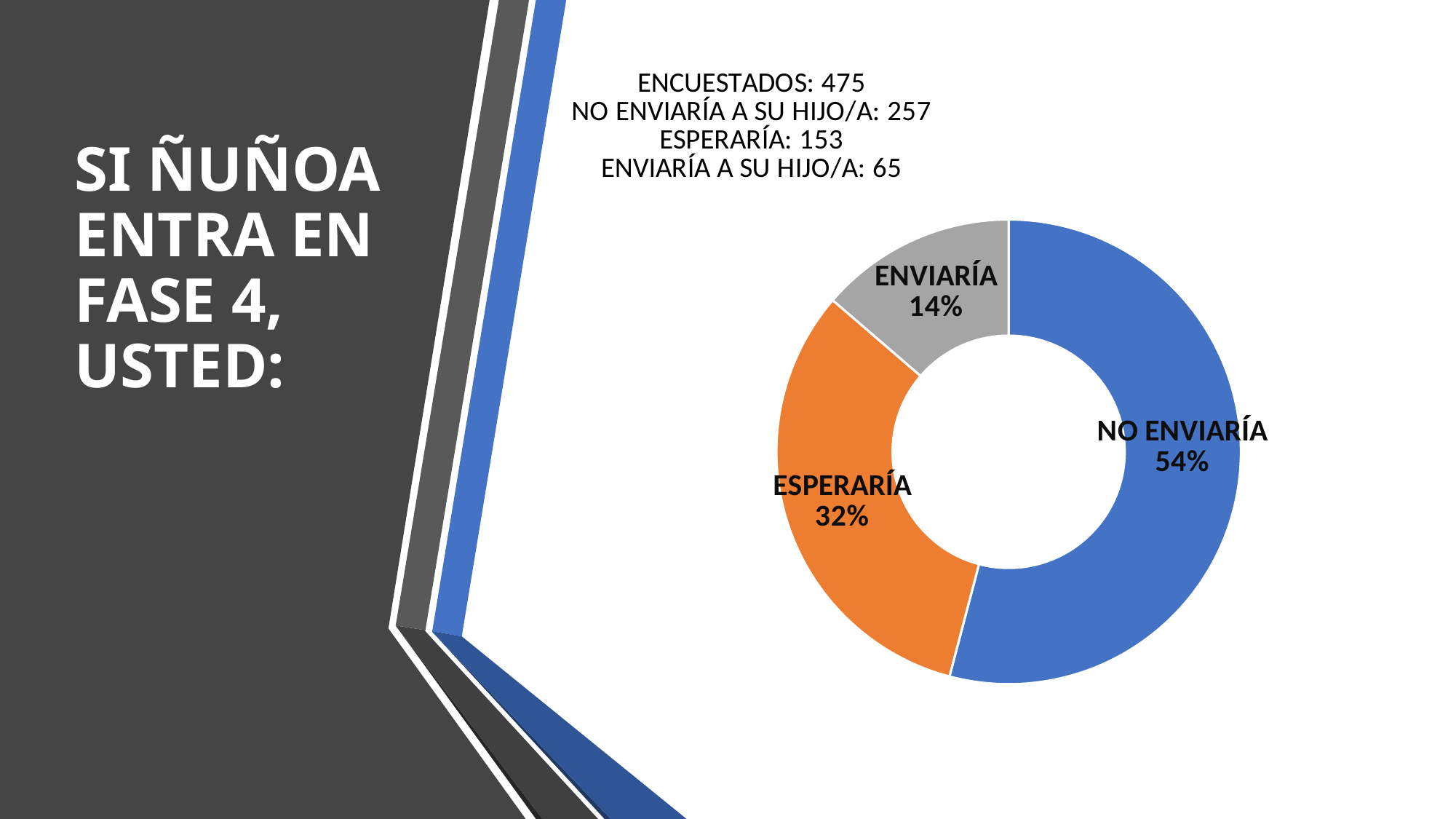
What is the difference in percentage points between the NO ENVIARÍA and ESPERARÍA slices? 22 What percentage of the doughnut chart is the NO ENVIARÍA slice? 54% According to the text above the chart, how many people were surveyed (ENCUESTADOS)? 475 What colour is the NO ENVIARÍA slice? Blue What is the difference in percentage points between the ESPERARÍA and ENVIARÍA slices? 18 How many slices does the doughnut chart have? 3 What kind of chart is shown on the slide? Doughnut chart What percentage of the doughnut chart is the ESPERARÍA slice? 32% Which slice of the doughnut chart is the smallest? ENVIARÍA Which slice of the doughnut chart is the largest? NO ENVIARÍA Which slice is larger, ESPERARÍA or ENVIARÍA? ESPERARÍA What percentage of the doughnut chart is the ENVIARÍA slice? 14%